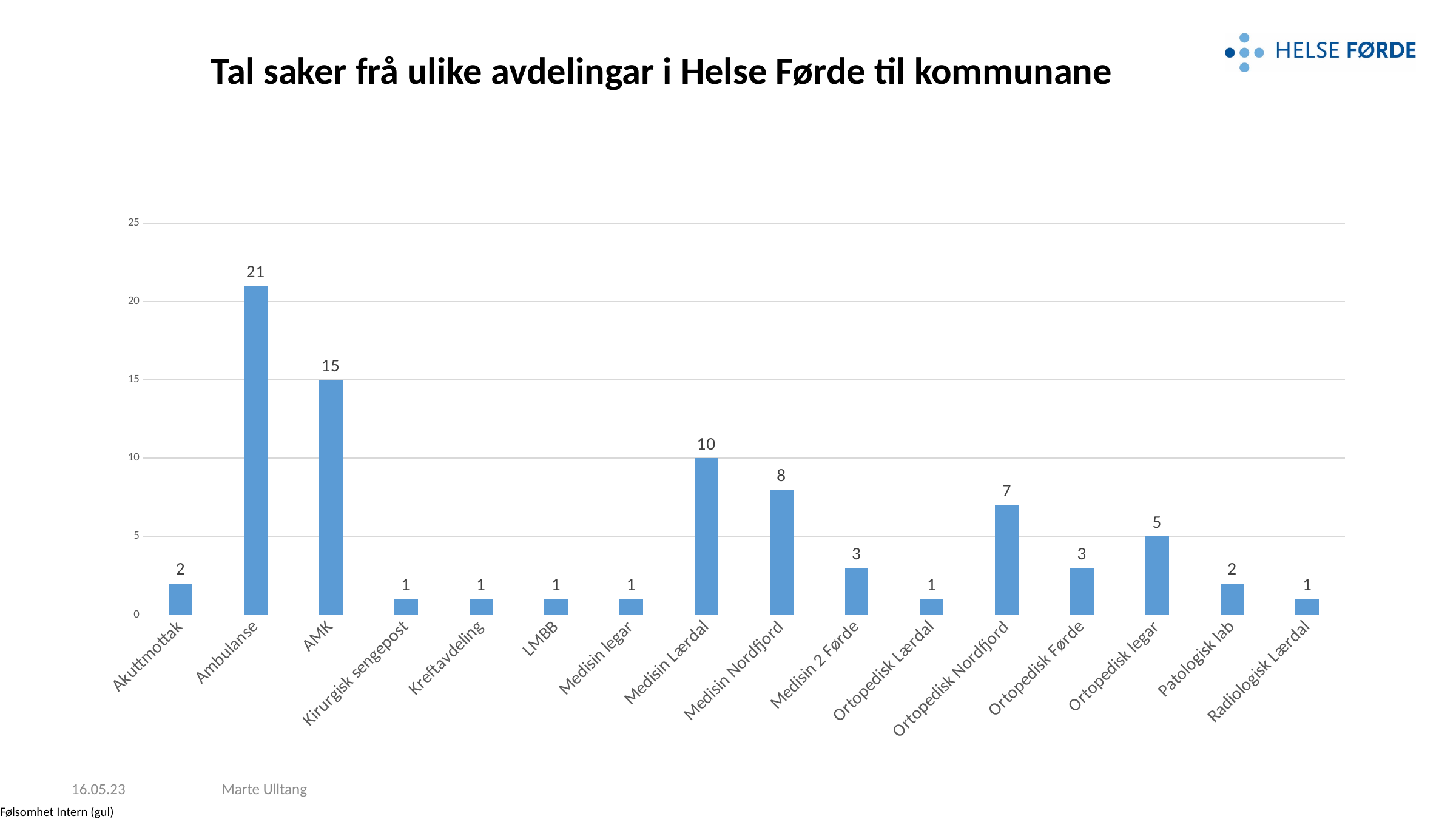
Is the value for AMK greater or less than 10? greater What is the value for Ortopedisk Nordfjord? 7 How many categories are shown on the x axis? 16 What is the value for Patologisk lab? 2 What is the difference between the values for Ambulanse and AMK? 6 What is the value for AMK? 15 Which category has the highest value? Ambulanse What is the difference between the values for Medisin Lærdal and Medisin Nordfjord? 2 Which is larger, the value for Ortopedisk legar or the value for Ortopedisk Nordfjord? Ortopedisk Nordfjord What is the value for Ambulanse? 21 What is the value for Medisin Lærdal? 10 What kind of chart is shown on the slide? Bar chart